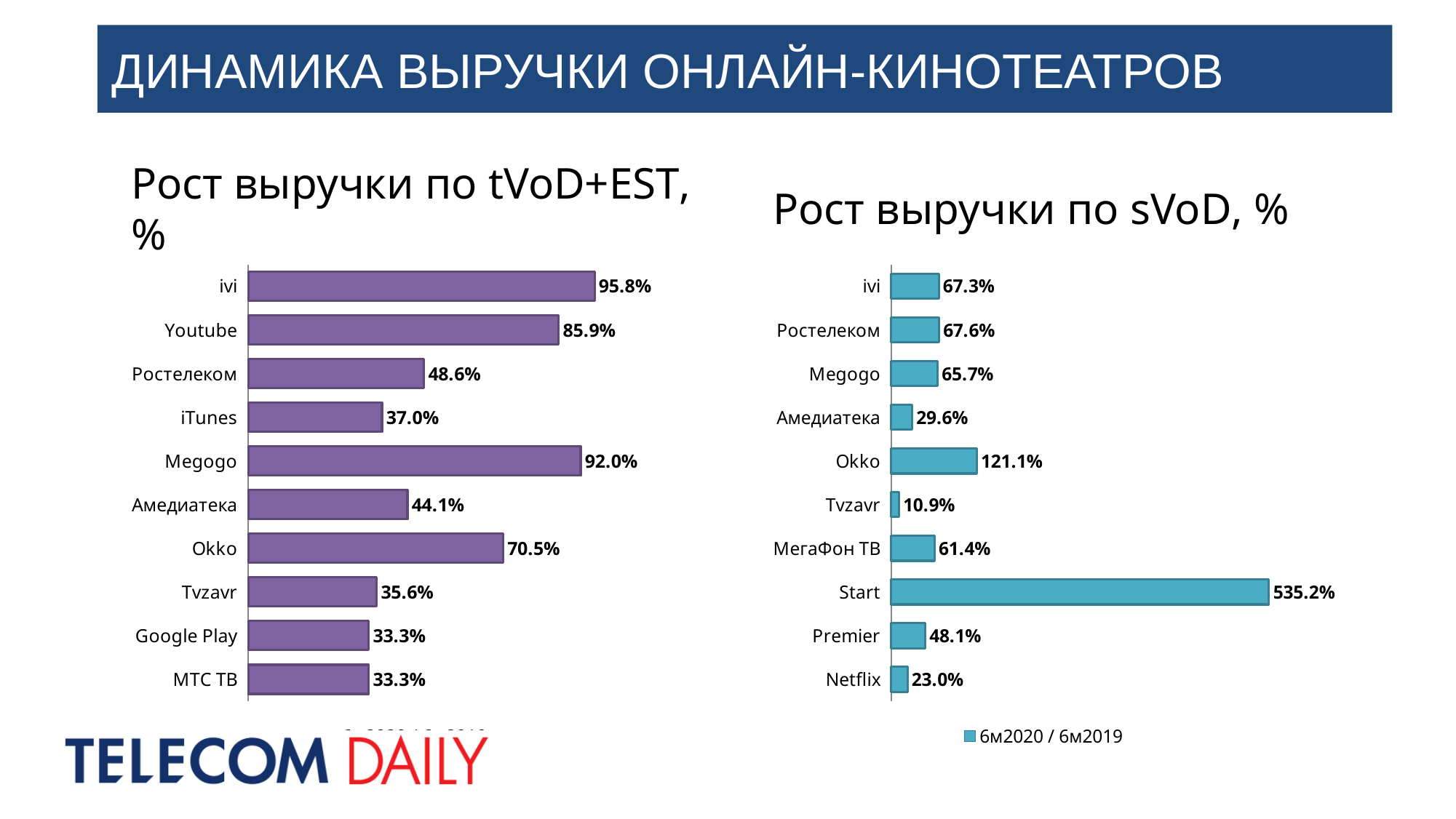
How many categories are shown in the chart 'Рост выручки по tVoD+EST, %'? 10 In the chart 'Рост выручки по sVoD, %', what is the value for Start? 535.2% How many categories are shown in the chart 'Рост выручки по sVoD, %'? 10 In the chart 'Рост выручки по tVoD+EST, %', which category has the highest value? ivi In the chart 'Рост выручки по tVoD+EST, %', what is the value for Okko? 70.5% In the chart 'Рост выручки по tVoD+EST, %', what is the value for Megogo? 92.0% What kind of chart is 'Рост выручки по sVoD, %'? Bar chart In the chart 'Рост выручки по sVoD, %', which is larger, the value for Okko or the value for Premier? Okko In the chart 'Рост выручки по tVoD+EST, %', what is the difference between the values for ivi and Youtube? 9.9% In the chart 'Рост выручки по sVoD, %', which category has the lowest value? Tvzavr What legend entry is shown under the chart 'Рост выручки по sVoD, %'? 6м2020 / 6м2019 In the chart 'Рост выручки по sVoD, %', what is the difference between the values for Ростелеком and Netflix? 44.6%